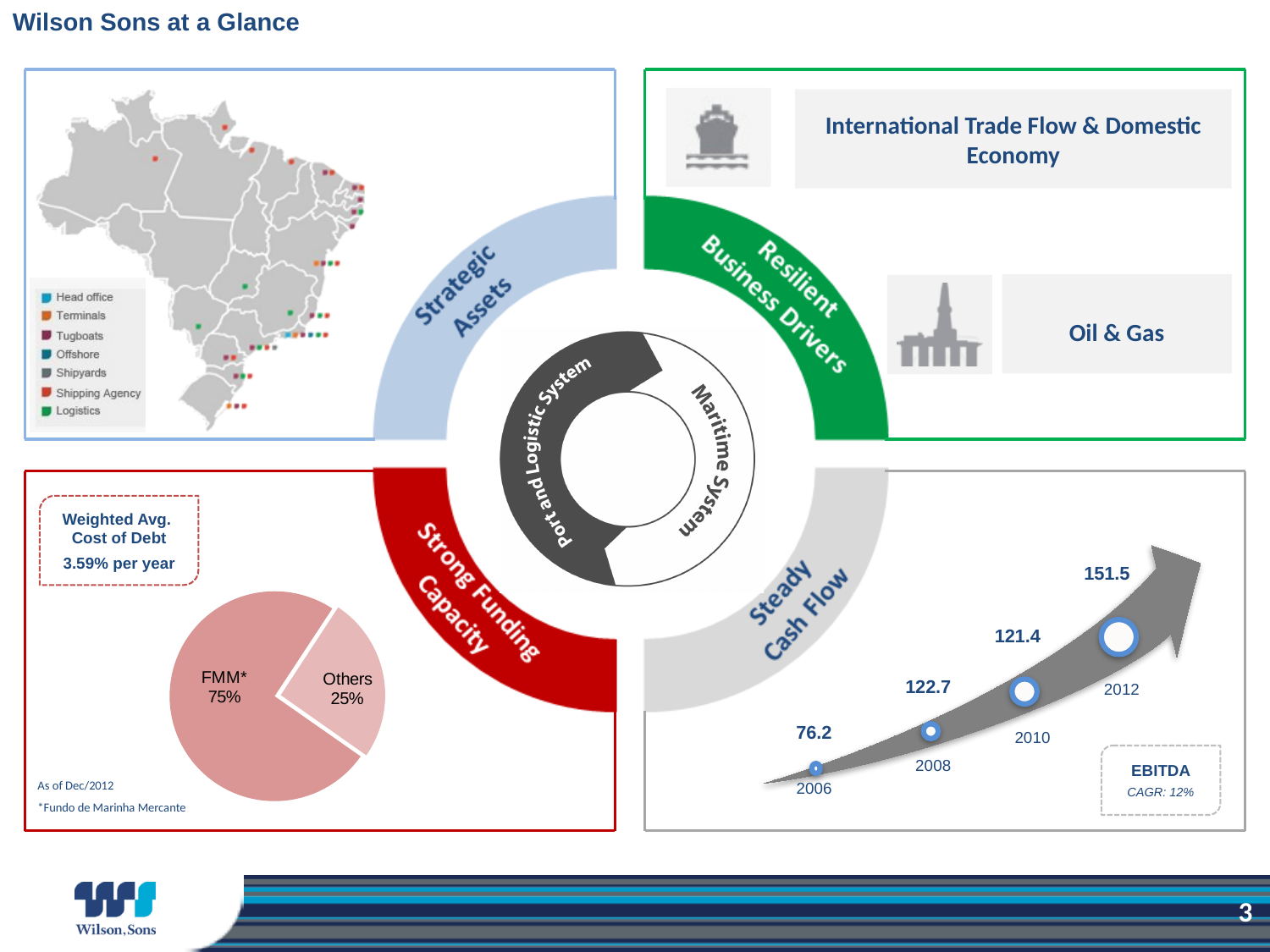
How many slices does the pie chart in the bottom-left panel have? 2 In the pie chart in the bottom-left panel, what share does FMM* hold? 75% In the EBITDA chart in the bottom-right panel, which year has the lowest value? 2006 In the pie chart in the bottom-left panel, what share does Others hold? 25% In the EBITDA chart in the bottom-right panel, what is the value for 2006? 76.2 In the EBITDA chart in the bottom-right panel, what is the value for 2012? 151.5 In the EBITDA chart in the bottom-right panel, what is the value for 2010? 121.4 In the EBITDA chart in the bottom-right panel, which year has the highest value? 2012 What kind of chart is shown in the bottom-left panel? Pie chart In the EBITDA chart in the bottom-right panel, what CAGR is stated? 12% In the pie chart in the bottom-left panel, which slice is larger, FMM* or Others? FMM* In the EBITDA chart in the bottom-right panel, what is the difference between the 2012 and 2006 values? 75.3